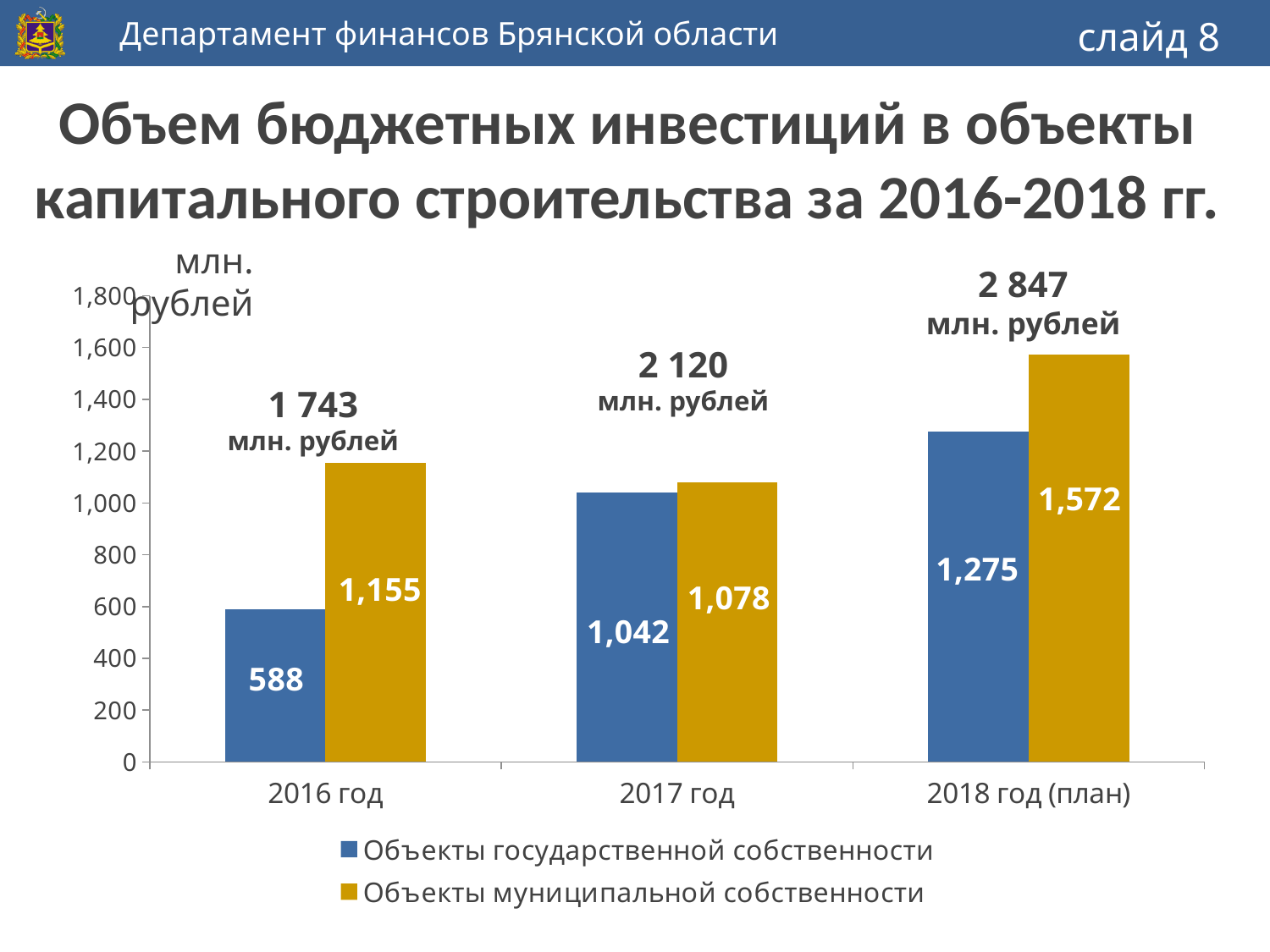
Which year has the highest value for Объекты государственной собственности? 2018 год (план) Which year has the lowest value for Объекты муниципальной собственности? 2017 год What is the total shown above the bars for 2017 год? 2 120 млн. рублей What is the value for Объекты государственной собственности in 2016 год? 588 What is the value for Объекты муниципальной собственности in 2018 год (план)? 1,572 What is the difference between Объекты муниципальной собственности and Объекты государственной собственности in 2016 год? 567 How many year categories are shown on the x axis? 3 Which is larger in 2017 год: Объекты государственной собственности or Объекты муниципальной собственности? Объекты муниципальной собственности What is the value for Объекты муниципальной собственности in 2017 год? 1,078 What kind of chart is shown on the slide? bar chart Is the value for Объекты государственной собственности in 2018 год (план) greater or less than 1,200? greater How many series does the legend list? 2